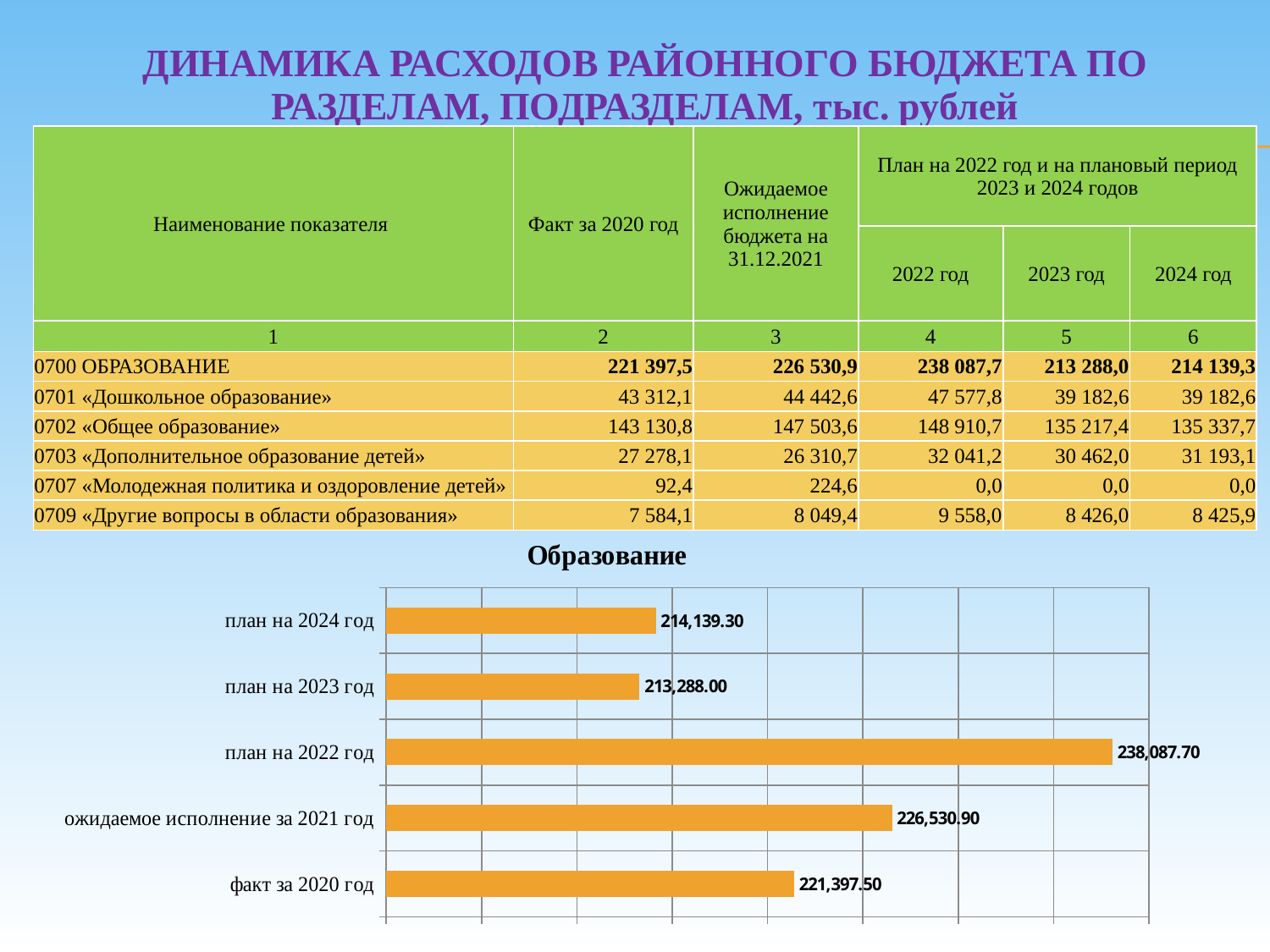
Which category has the lowest value in the chart? план на 2023 год What is the value for план на 2022 год in the chart? 238,087.70 How many bars are plotted in the chart? 5 Which category has the highest value in the chart? план на 2022 год What is the difference between ожидаемое исполнение за 2021 год and факт за 2020 год in the chart? 5,133.40 What is the title of the chart? Образование Which is larger in the chart: ожидаемое исполнение за 2021 год or факт за 2020 год? ожидаемое исполнение за 2021 год What is the value for ожидаемое исполнение за 2021 год in the chart? 226,530.90 What is the value for план на 2023 год in the chart? 213,288.00 What is the value for факт за 2020 год in the chart? 221,397.50 What type of chart is shown on the slide? bar chart What is the difference between план на 2022 год and план на 2023 год in the chart? 24,799.70